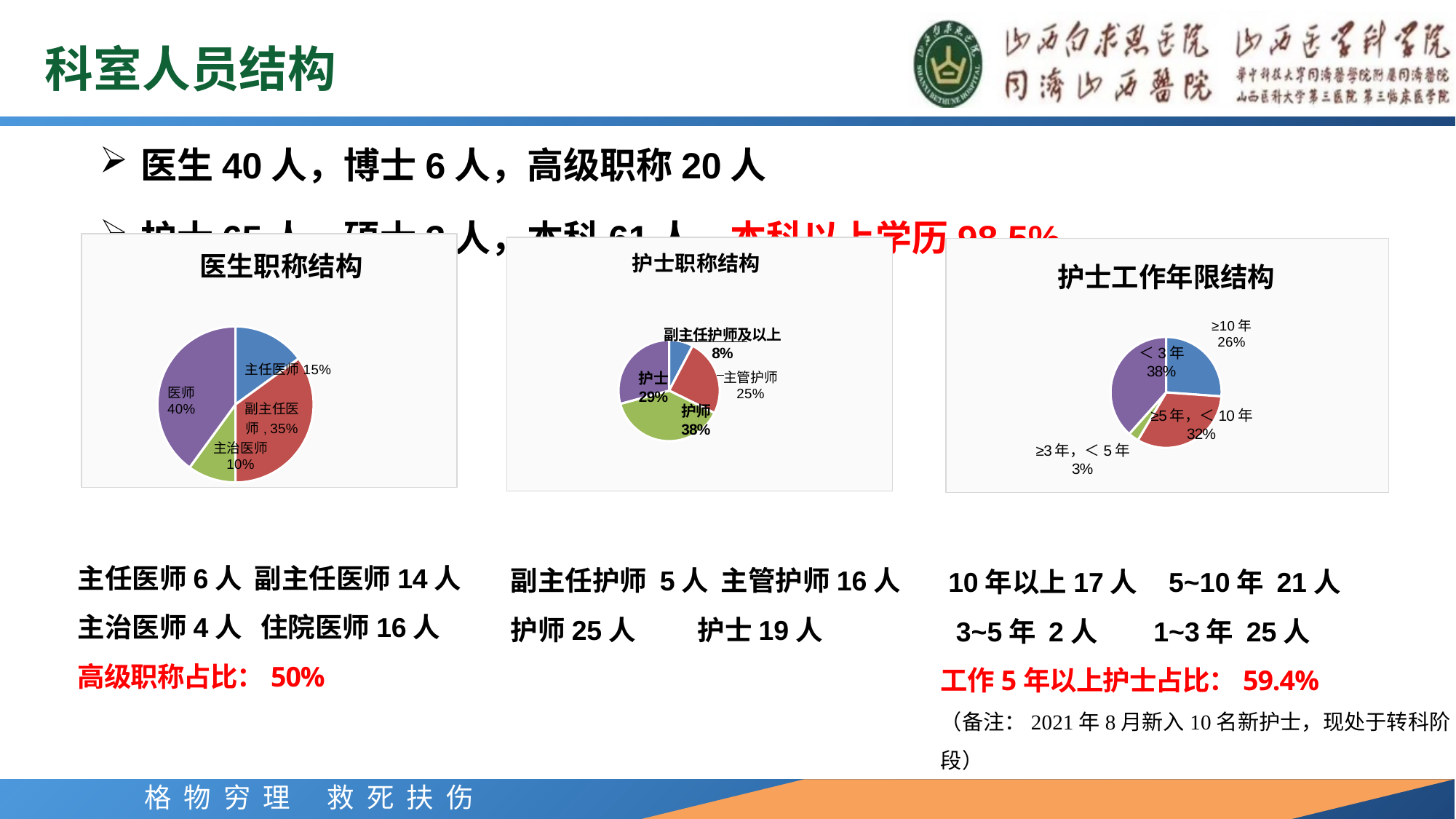
In the 护士工作年限结构 chart, which category has the smallest share? ≥3 年，＜5 年 How many charts are shown on the slide? 3 In the 护士职称结构 chart, which category has the largest share? 护师 What type of chart is the 护士工作年限结构 chart? pie chart In the 医生职称结构 chart, which category has the smallest share? 主治医师 How many slices does the 医生职称结构 pie chart have? 4 In the 医生职称结构 chart, what share does 医师 have? 40% In the 护士职称结构 chart, what share does 主管护师 have? 25% In the 护士工作年限结构 chart, what share does ≥10 年 have? 26% In the 护士职称结构 chart, which is larger, 护士 or 主管护师? 护士 In the 医生职称结构 chart, what is the difference between the shares of 副主任医师 and 主任医师? 20% In the 护士职称结构 chart, what is the difference between the shares of 护师 and 副主任护师及以上? 30%